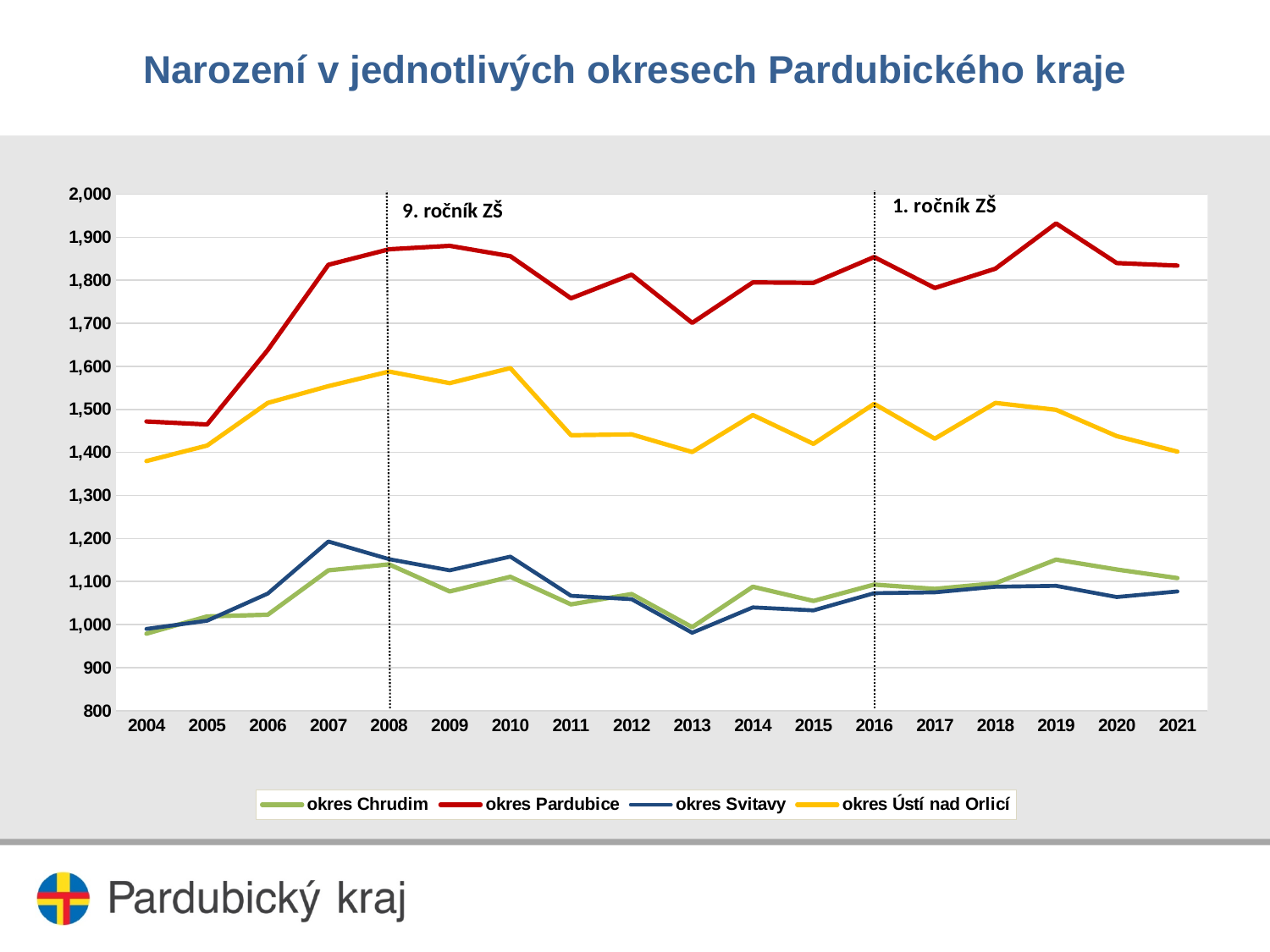
In 2007, which is larger: okres Svitavy or okres Chrudim? okres Svitavy Which district has the highest number of births in 2019? okres Pardubice At which year is the dotted vertical line labelled "1. ročník ZŠ" placed? 2016 Is the value for okres Ústí nad Orlicí in 2010 greater or less than 1,500? greater Is the value for okres Svitavy in 2013 greater or less than 1,100? less How many years are plotted along the x axis? 18 In which year does the okres Pardubice line reach its highest value? 2019 Does the okres Pardubice line rise or fall between 2004 and 2007? rise How many series does the legend list? 4 Which district has the lowest value in 2007? okres Chrudim Is the value for okres Pardubice in 2019 greater or less than 1,900? greater What kind of chart is shown on the slide? line chart